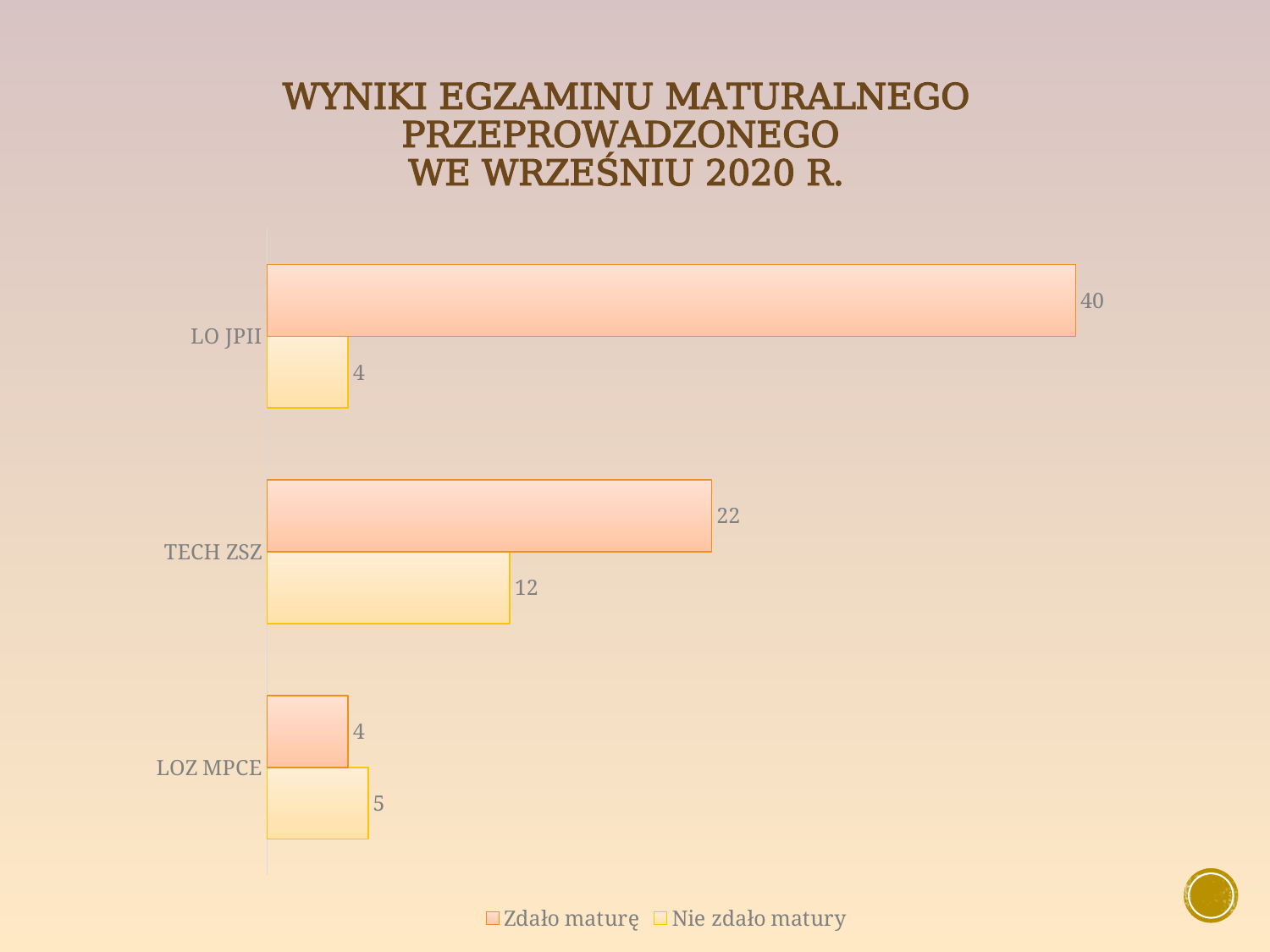
What is the value of "Zdało maturę" for LO JPII? 40 What is the total of "Zdało maturę" across all three categories? 66 What is the value of "Nie zdało matury" for TECH ZSZ? 12 What is the value of "Zdało maturę" for LOZ MPCE? 4 Which category has the highest value for "Zdało maturę"? LO JPII How many series does the legend list? 2 What is the difference between "Zdało maturę" and "Nie zdało matury" for TECH ZSZ? 10 What kind of chart is shown on the slide? bar chart Which category has the lowest value for "Nie zdało matury"? LO JPII What is the value of "Nie zdało matury" for LO JPII? 4 For LOZ MPCE, which is larger: "Zdało maturę" or "Nie zdało matury"? Nie zdało matury How many categories are shown on the chart? 3